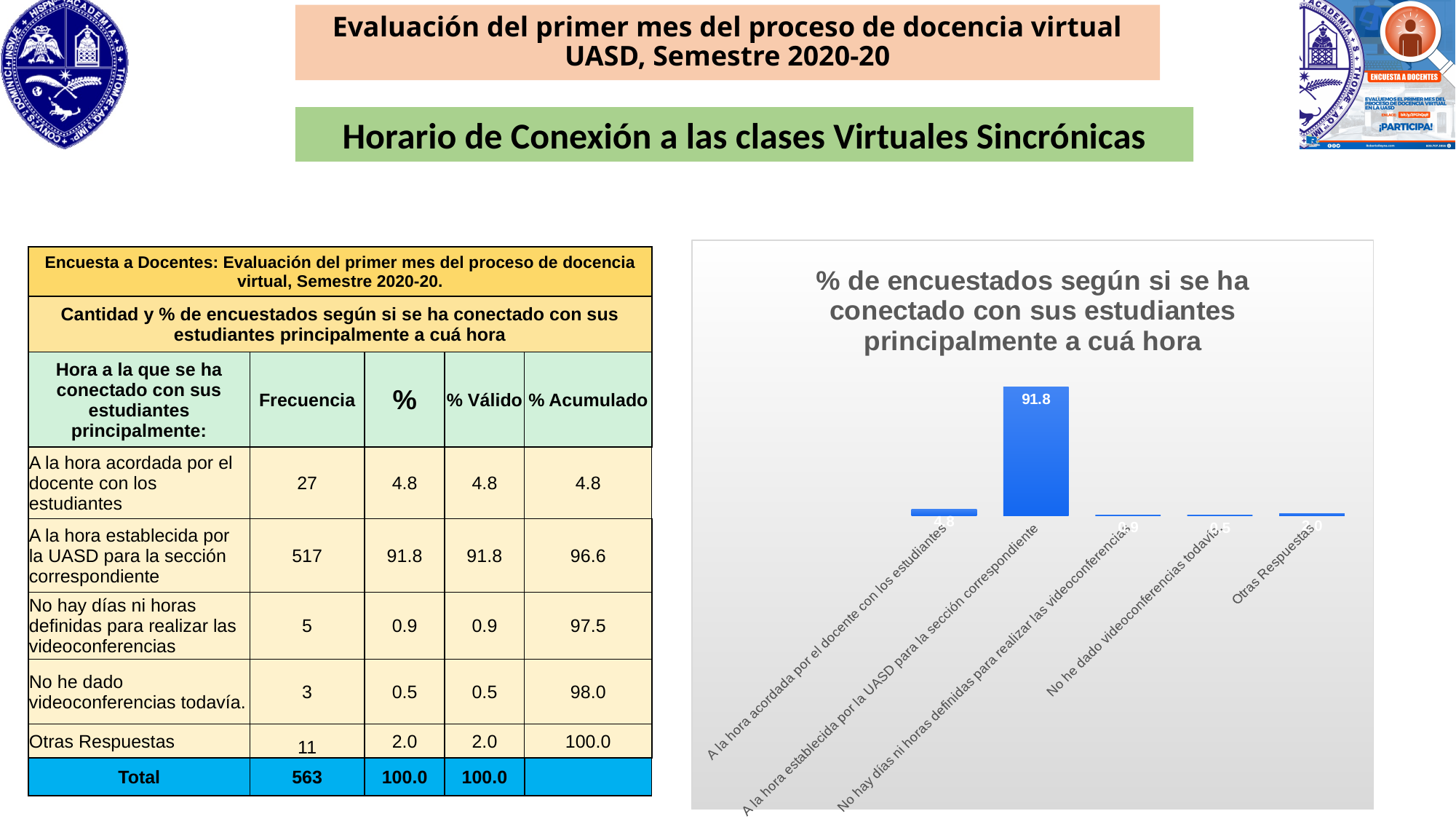
What kind of chart is shown on the slide? bar chart Which is larger in the bar chart: the value for 'Otras Respuestas' or the value for 'No hay días ni horas definidas para realizar las videoconferencias'? Otras Respuestas What is the difference between the values for 'A la hora establecida por la UASD para la sección correspondiente' and 'A la hora acordada por el docente con los estudiantes' in the bar chart? 87.0 How many categories does the bar chart show? 5 Which category has the highest value in the bar chart? A la hora establecida por la UASD para la sección correspondiente Which category has the lowest value in the bar chart? No he dado videoconferencias todavía What is the title of the bar chart? % de encuestados según si se ha conectado con sus estudiantes principalmente a cuá hora What is the value for 'A la hora establecida por la UASD para la sección correspondiente' in the bar chart? 91.8 What is the value for 'No he dado videoconferencias todavía' in the bar chart? 0.5 What is the value for 'No hay días ni horas definidas para realizar las videoconferencias' in the bar chart? 0.9 What is the value for 'Otras Respuestas' in the bar chart? 2.0 What is the value for 'A la hora acordada por el docente con los estudiantes' in the bar chart? 4.8